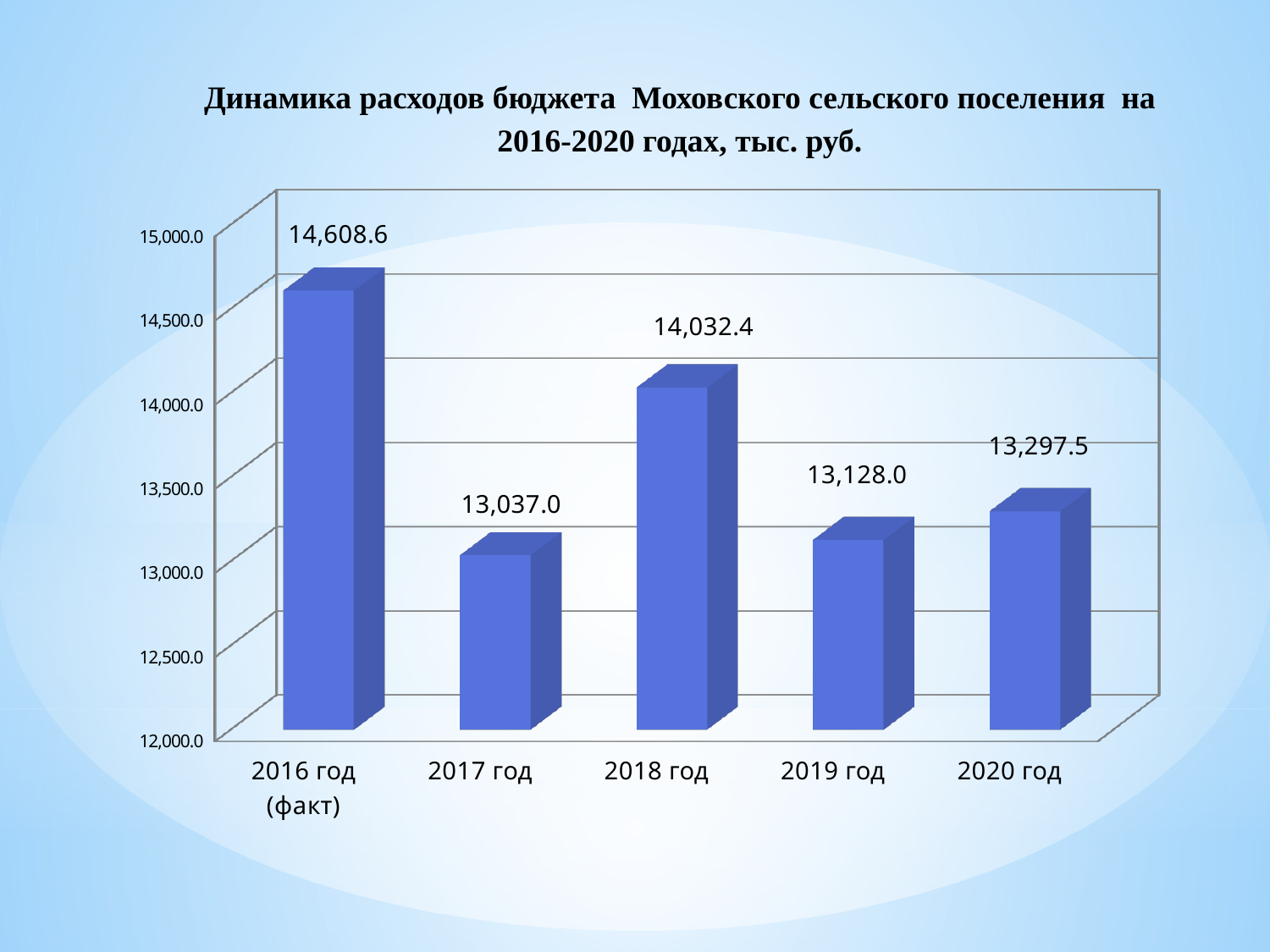
What is the value for 2017 год? 13,037.0 What is the difference between the values for 2016 год (факт) and 2017 год? 1,571.6 What is the difference between the values for 2018 год and 2019 год? 904.4 What kind of chart is shown on the slide? bar chart Is the value for 2018 год greater or less than 14,000.0? greater Which is larger, the value for 2019 год or the value for 2020 год? 2020 год How many years are shown on the chart? 5 Which year has the lowest value? 2017 год Which year has the highest value? 2016 год (факт) Does the value rise or fall from 2018 год to 2019 год? fall What is the value for 2016 год (факт)? 14,608.6 What is the value for 2020 год? 13,297.5